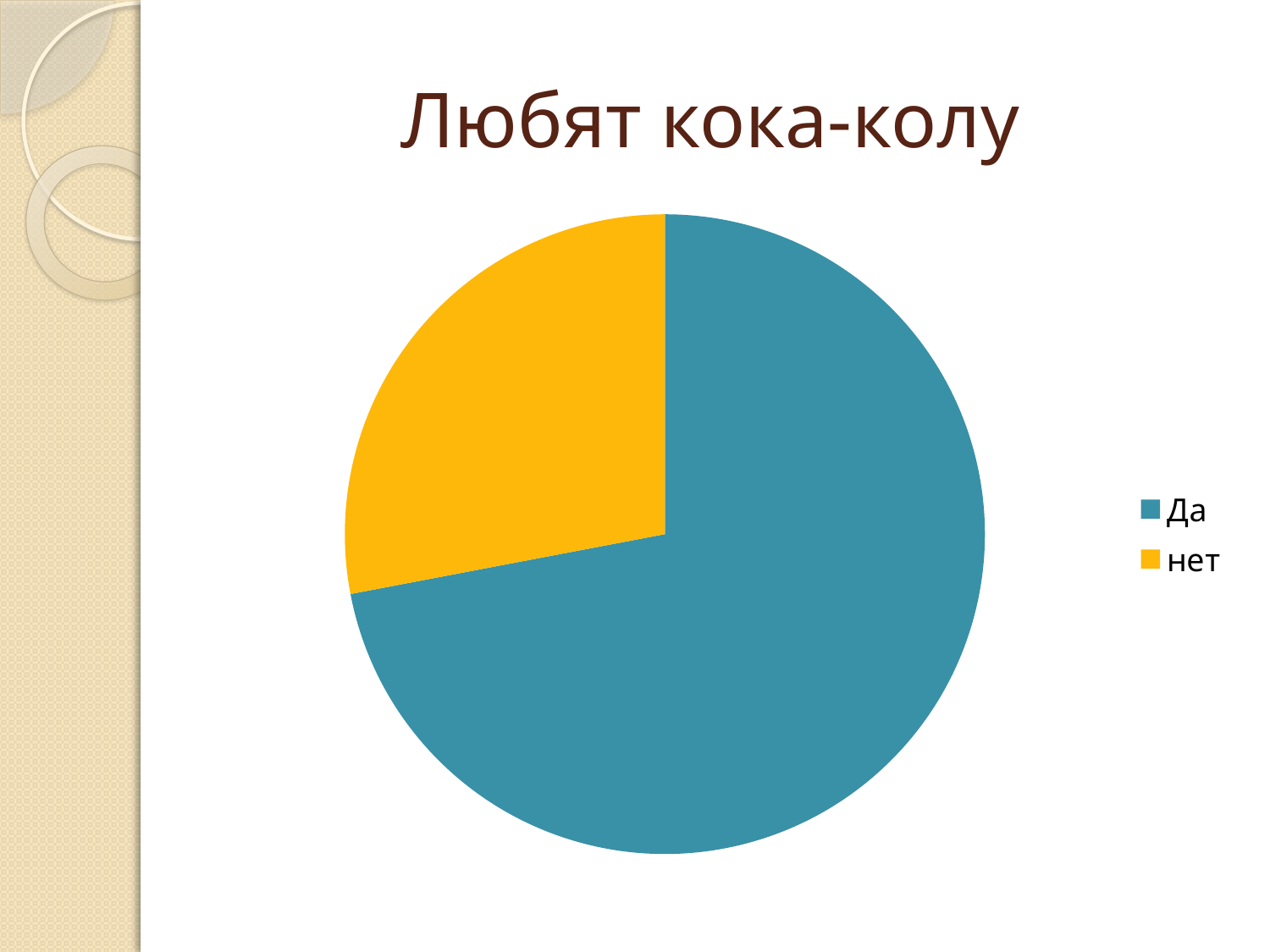
Which category has the smallest slice of the pie? нет What kind of chart is shown on the slide? pie chart Which category has the largest slice of the pie? Да What is the title of the chart? Любят кока-колу How many slices does the pie chart have? 2 Does the "Да" slice take up more or less than half of the pie? more Which slice is larger, "Да" or "нет"? Да How many entries does the legend list? 2 What colour is the slice for "нет"? yellow